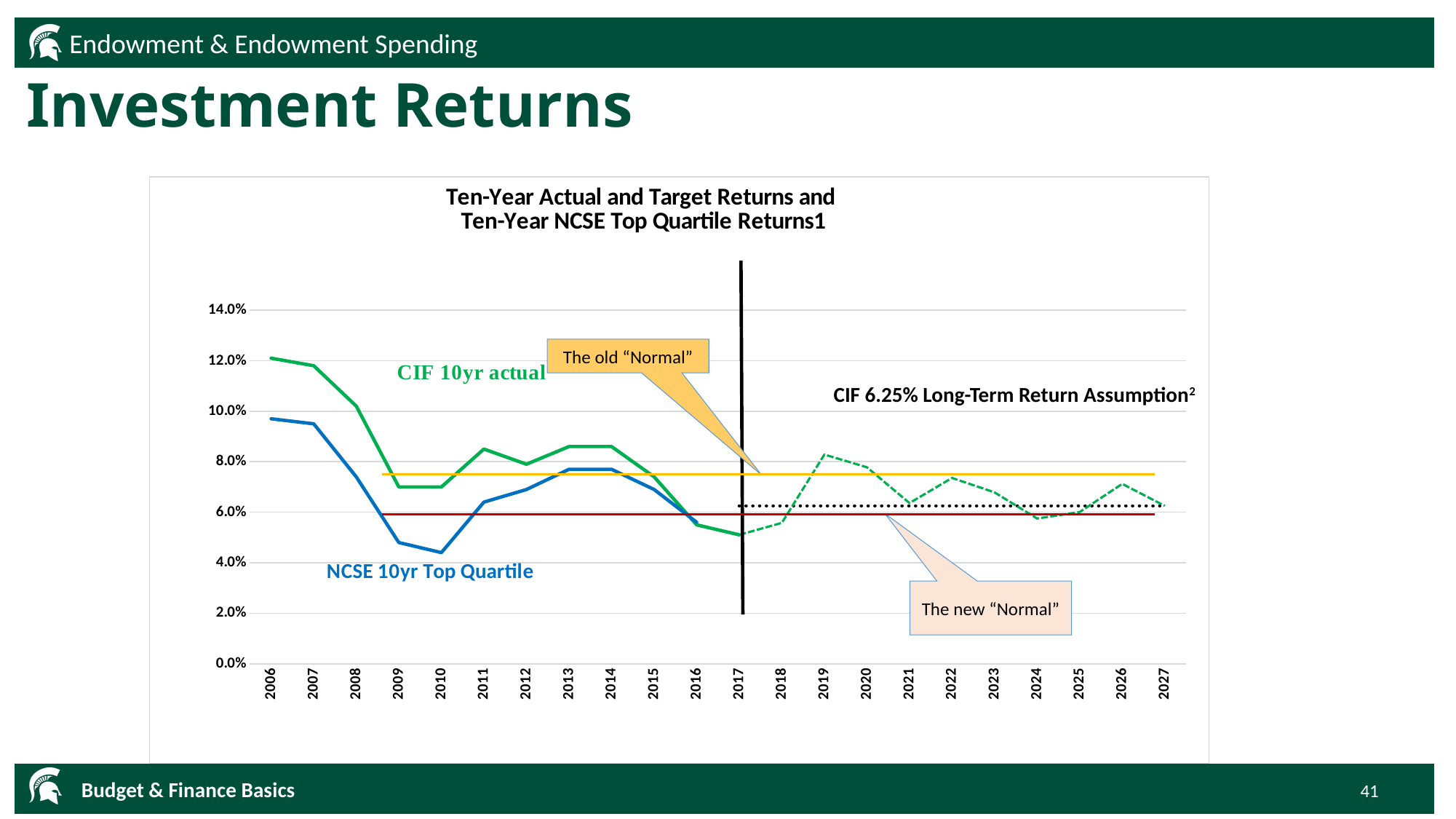
Is the CIF 10yr actual value for 2017 greater or less than 6.0%? less Is the NCSE 10yr Top Quartile value for 2006 greater or less than 8.0%? greater What kind of chart is shown on the slide? Line chart In 2013, which is larger: the CIF 10yr actual or the NCSE 10yr Top Quartile? CIF 10yr actual Is the CIF 10yr actual value for 2006 greater or less than 10.0%? greater Does the CIF 10yr actual line rise or fall from 2014 to 2017? Fall What is the title of the chart? Ten-Year Actual and Target Returns and Ten-Year NCSE Top Quartile Returns1 In which year is the CIF 10yr actual line at its highest? 2006 Does the NCSE 10yr Top Quartile line rise or fall from 2006 to 2010? Fall How many years are labelled along the x axis of the chart? 22 What is the CIF long-term return assumption stated on the chart? 6.25%